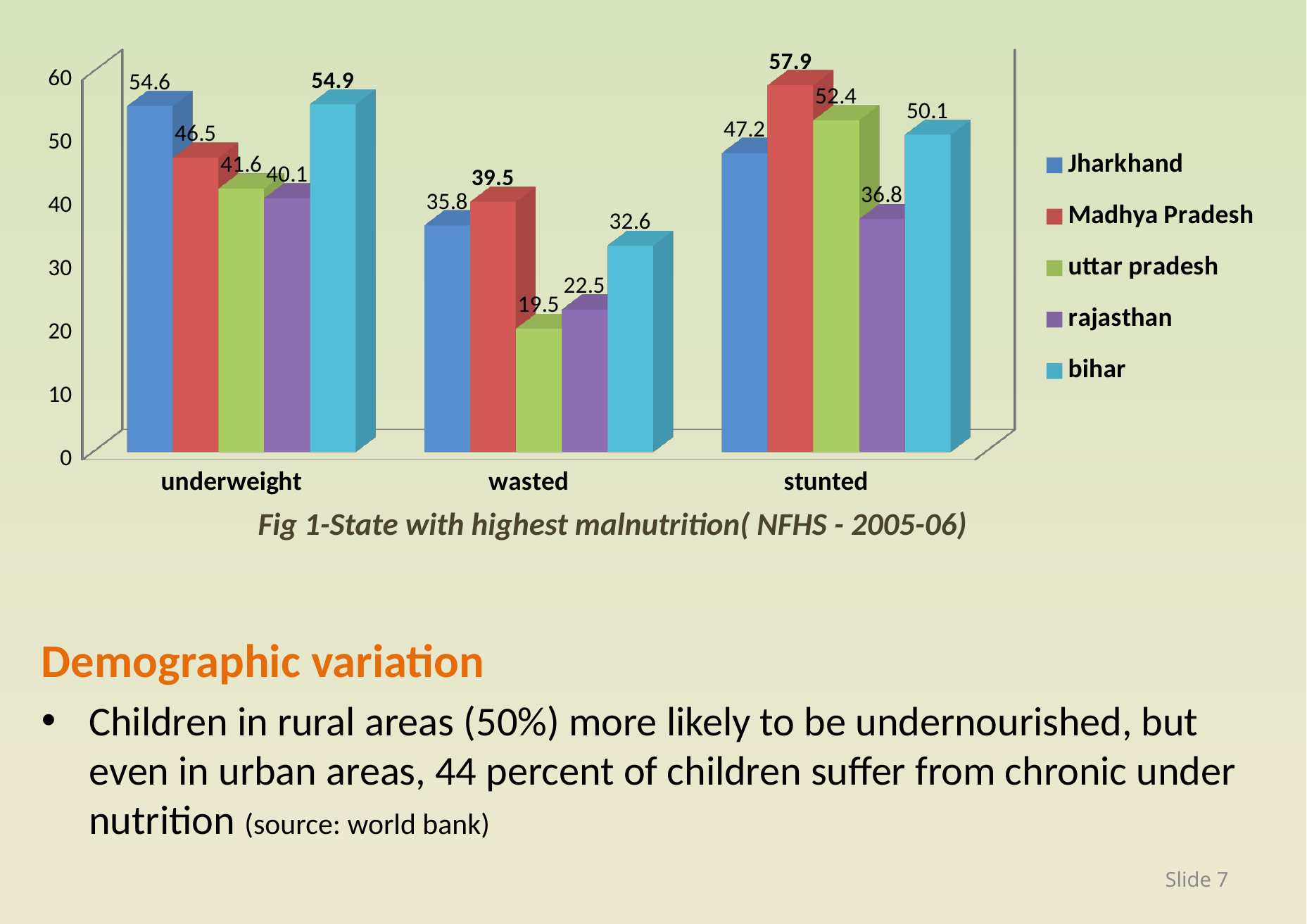
What is the difference between Jharkhand and rajasthan in the underweight category? 14.5 What kind of chart is shown on the slide? bar chart How many series does the legend list? 5 How many categories are shown on the x axis? 3 What is the value for bihar in the underweight category? 54.9 Which state has the lowest value in the stunted category? rajasthan Which state has the highest value in the wasted category? Madhya Pradesh What is the value for Madhya Pradesh in the stunted category? 57.9 Which is larger in the stunted category: uttar pradesh or bihar? uttar pradesh Is the value for rajasthan in the wasted category greater or less than 30? less What is the caption of the chart? Fig 1-State with highest malnutrition( NFHS - 2005-06) What is the value for uttar pradesh in the wasted category? 19.5